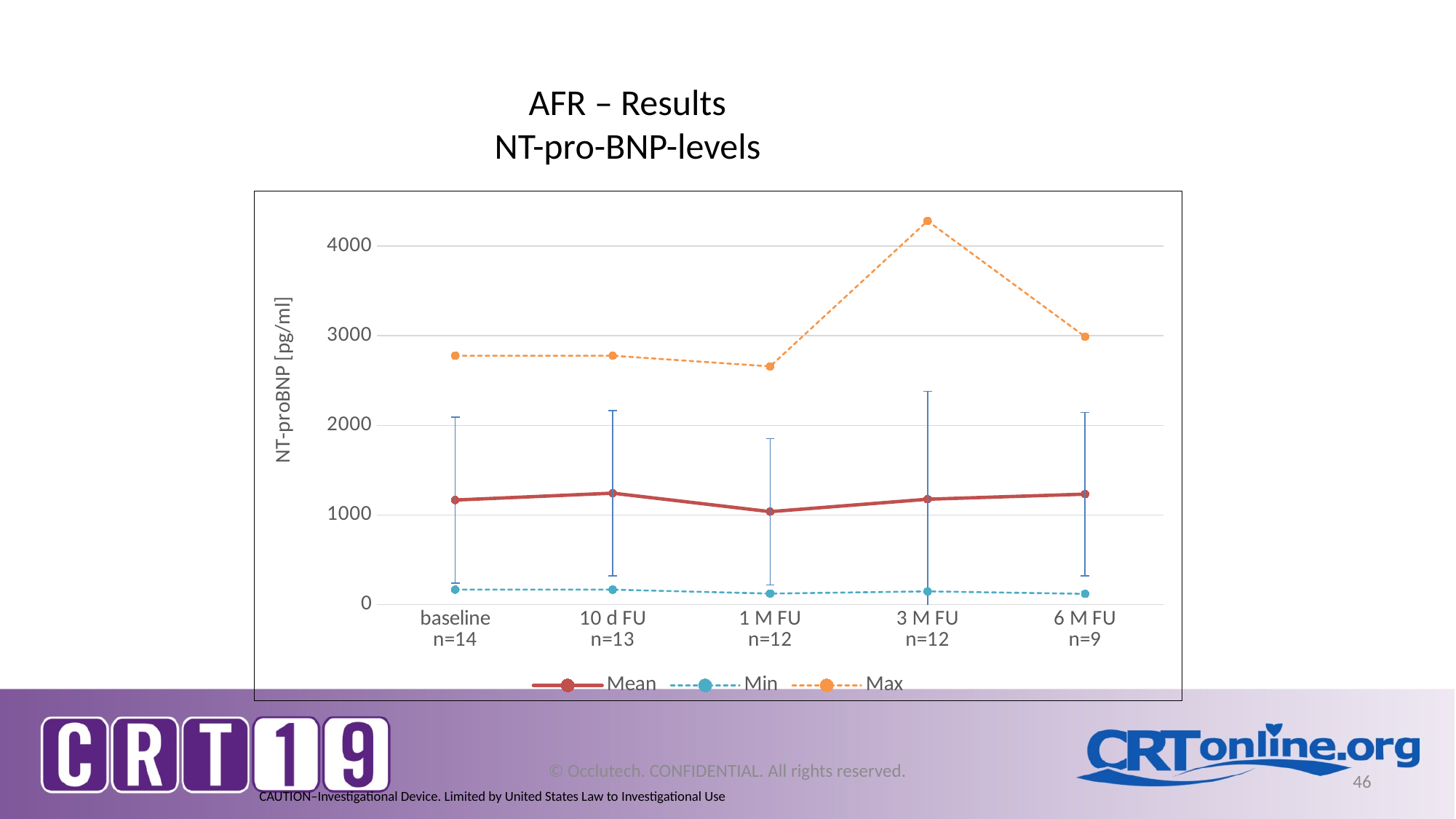
Which series has the lowest values across all time points? Min Is the Max value at 3 M FU greater or less than 4000? greater Is the Min value at 6 M FU greater or less than 1000? less How many series does the legend list? 3 What kind of chart is shown on the slide? line chart How many time points are plotted along the x axis? 5 Is the Mean value at 10 d FU greater or less than 2000? less At which time point does the Max series reach its highest value? 3 M FU What is the sample size (n) shown for the 6 M FU time point? n=9 What is the label of the y axis? NT-proBNP [pg/ml] Which is larger, the Max value at 3 M FU or the Max value at 6 M FU? 3 M FU